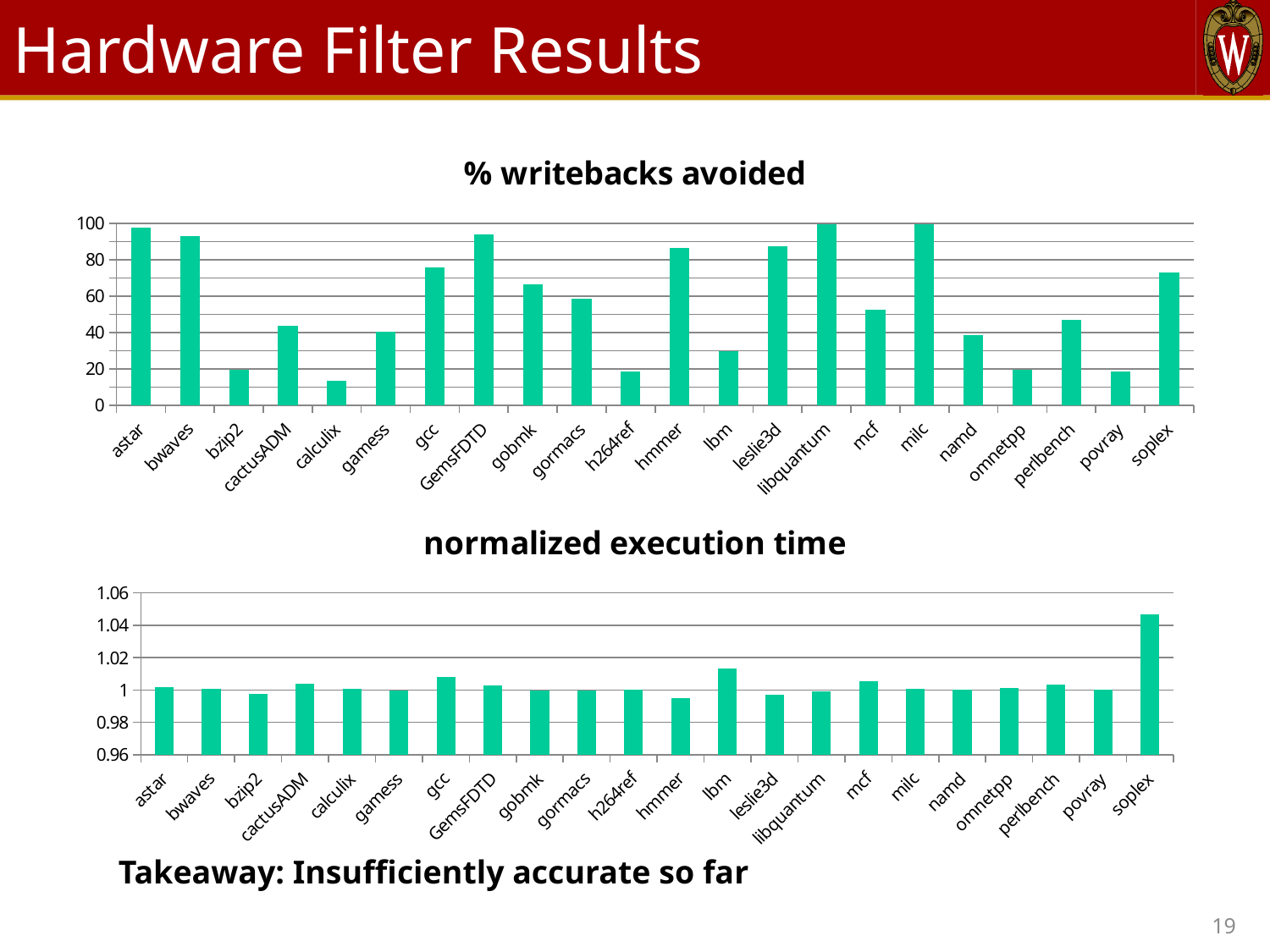
In the '% writebacks avoided' chart, is the value for bzip2 greater or less than 40? less In the 'normalized execution time' chart, is the value for soplex greater or less than 1.04? greater In the 'normalized execution time' chart, is the value for lbm greater or less than 1? greater What is the title of the bottom chart on the slide? normalized execution time How many benchmark categories are plotted in the '% writebacks avoided' chart? 22 In the 'normalized execution time' chart, which is larger, the value for soplex or the value for lbm? soplex What kind of chart is the '% writebacks avoided' chart? bar chart In the '% writebacks avoided' chart, which is larger, the value for astar or the value for bzip2? astar In the 'normalized execution time' chart, which benchmark has the highest value? soplex In the '% writebacks avoided' chart, which benchmark has the lowest value? calculix